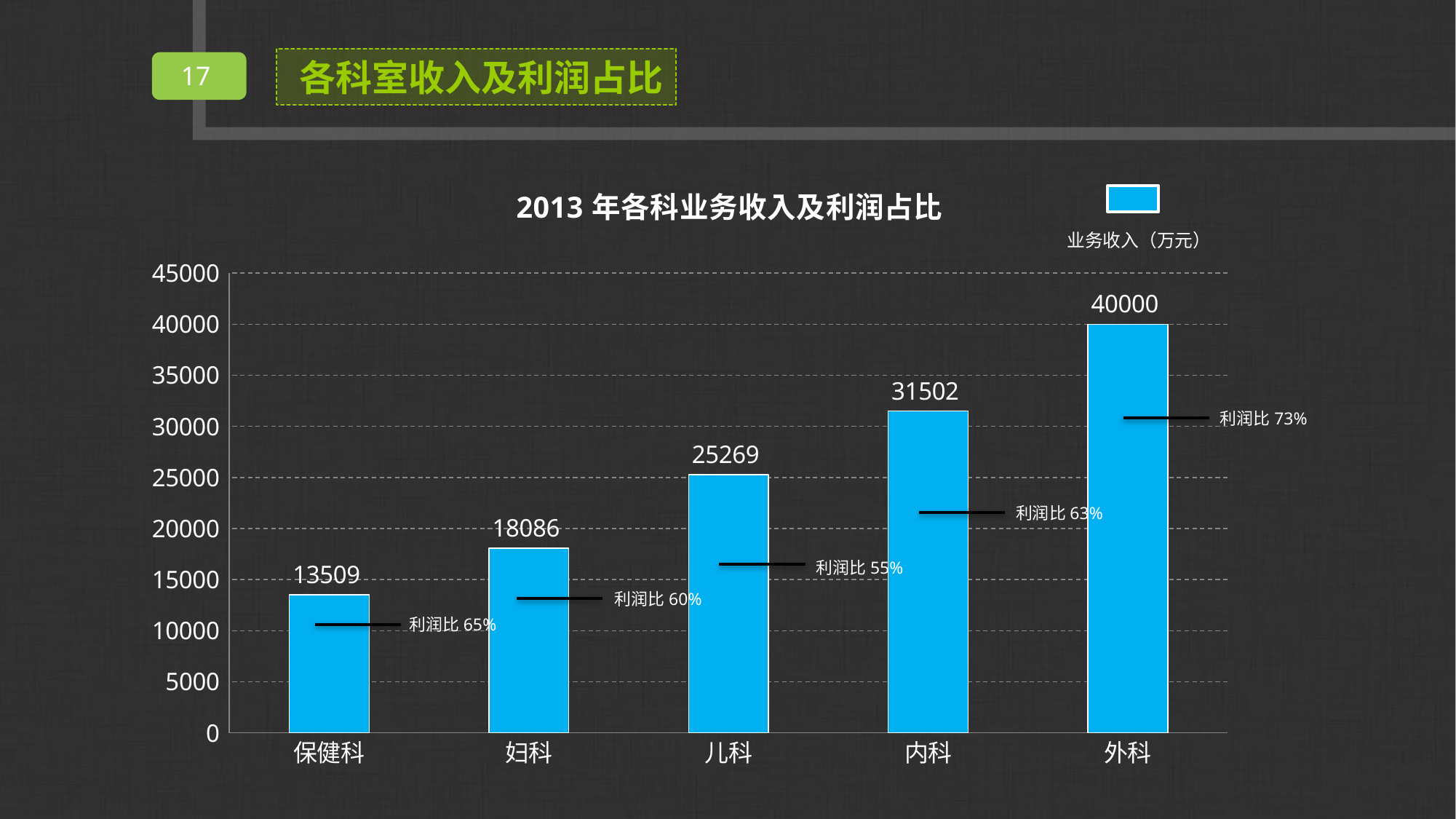
What is the title of the chart? 2013 年各科业务收入及利润占比 What is the business revenue (业务收入) for 保健科? 13509 What is the difference in business revenue between 外科 and 内科? 8498 Which department has the highest business revenue? 外科 What kind of chart is shown on the slide? Bar chart What is the profit ratio (利润比) annotated for 外科? 73% Which department has the lowest business revenue? 保健科 Which has higher business revenue, 妇科 or 儿科? 儿科 Do the business revenue values rise or fall from left to right along the x axis? Rise What is the profit ratio (利润比) annotated for 儿科? 55% How many departments are shown on the x axis? 5 What is the business revenue (业务收入) for 内科? 31502